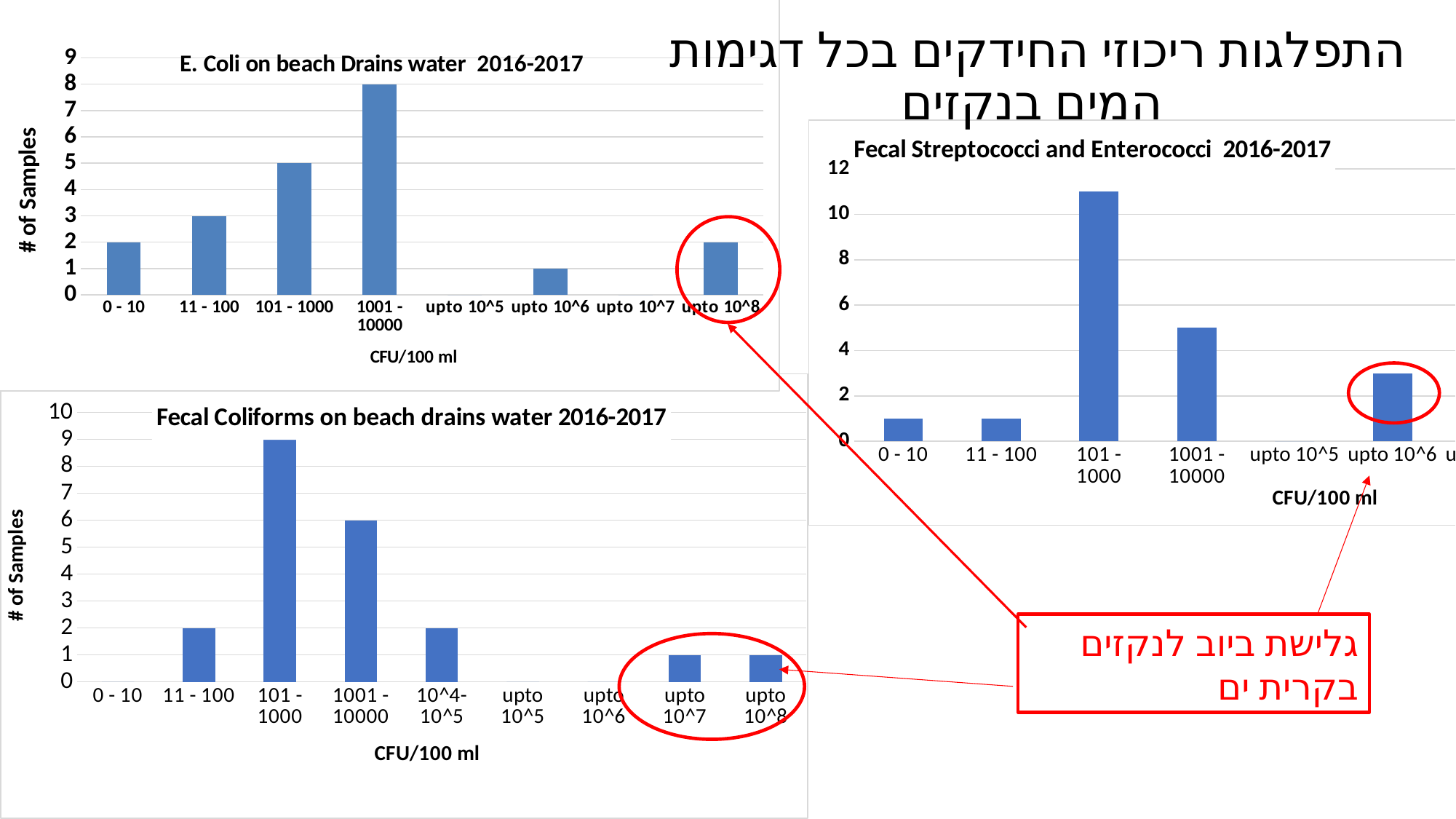
In the E. Coli on beach Drains water 2016-2017 chart, which category has the highest number of samples? 1001 - 10000 In the E. Coli on beach Drains water 2016-2017 chart, how many samples fall in the 1001 - 10000 category? 8 In the Fecal Coliforms on beach drains water 2016-2017 chart, which is larger: the value for 11 - 100 or the value for upto 10^7? 11 - 100 What type of chart is the E. Coli on beach Drains water 2016-2017 chart? bar chart In the Fecal Coliforms on beach drains water 2016-2017 chart, how many categories are shown on the x axis? 9 In the Fecal Coliforms on beach drains water 2016-2017 chart, which category has the highest number of samples? 101 - 1000 In the Fecal Streptococci and Enterococci 2016-2017 chart, is the value for 101 - 1000 greater or less than 10? greater In the E. Coli on beach Drains water 2016-2017 chart, what is the difference between the number of samples in 101 - 1000 and in 11 - 100? 2 In the E. Coli on beach Drains water 2016-2017 chart, how many samples are in the upto 10^8 category? 2 In the Fecal Streptococci and Enterococci 2016-2017 chart, is the value for upto 10^6 greater or less than 4? less In the Fecal Streptococci and Enterococci 2016-2017 chart, which category has the highest number of samples? 101 - 1000 In the Fecal Coliforms on beach drains water 2016-2017 chart, how many samples are in the 1001 - 10000 category? 6